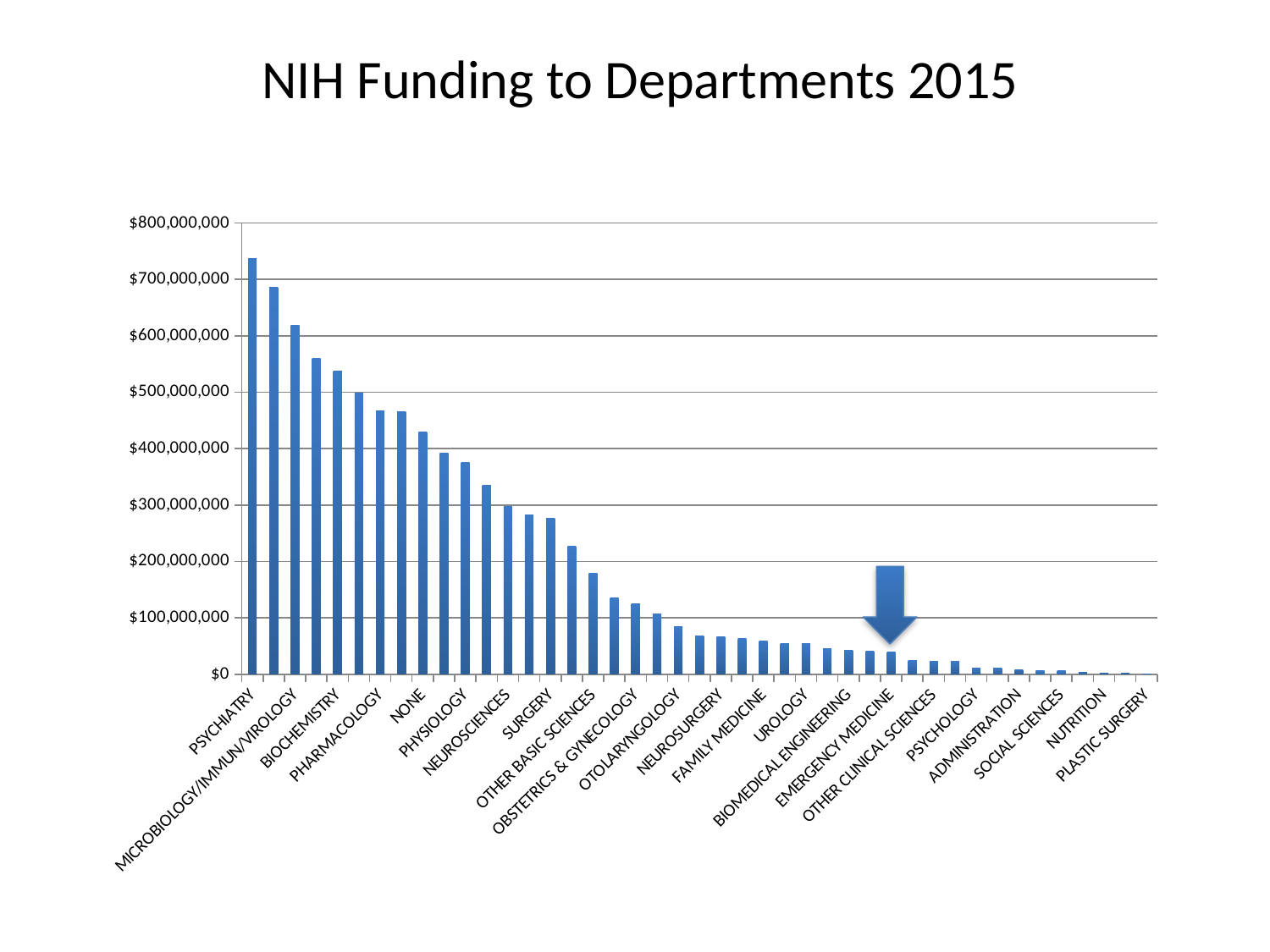
Is the value for OTHER BASIC SCIENCES greater or less than $200,000,000? less Which department has the highest NIH funding in the chart? PSYCHIATRY What kind of chart is shown on the slide? bar chart Which department's bar does the blue arrow on the chart point to? EMERGENCY MEDICINE Do the funding values rise or fall moving from left to right along the x axis? fall Is the value for SURGERY greater or less than $300,000,000? less Which has the larger value, PHARMACOLOGY or PHYSIOLOGY? PHARMACOLOGY Is the value for PSYCHIATRY greater or less than $700,000,000? greater Which labeled department has the lowest NIH funding in the chart? PLASTIC SURGERY What is the title of the chart? NIH Funding to Departments 2015